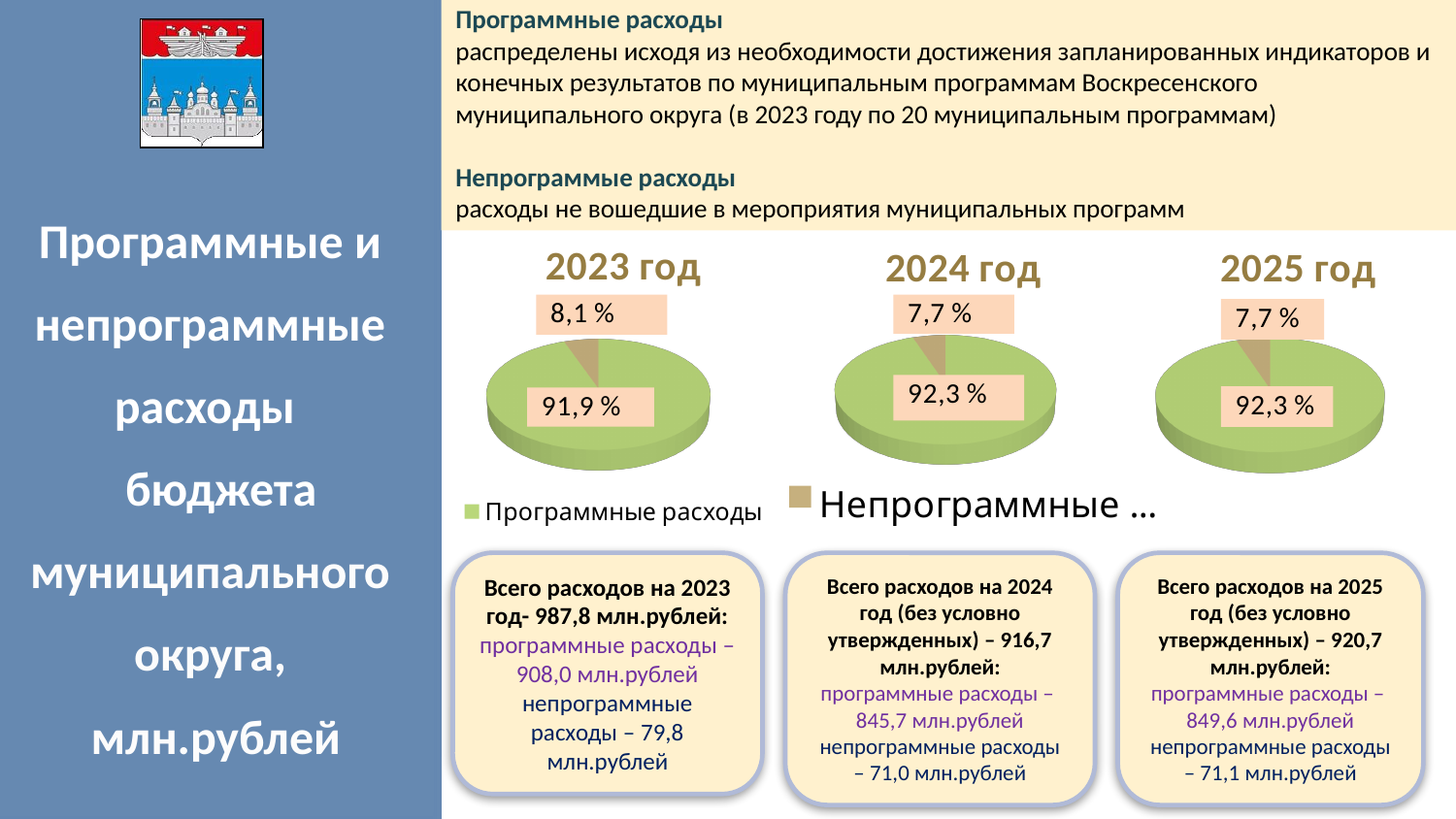
What kind of chart is used for 2023 год, 2024 год and 2025 год? Pie chart In the 2023 год pie chart, what share is labelled for the smaller (brown) slice, Непрограммные расходы? 8,1 % In the 2025 год pie chart, which slice is the smallest? Непрограммные расходы In the 2023 год pie chart, which slice is the largest? Программные расходы What is the difference between the Программные расходы share and the Непрограммные расходы share in the 2023 год pie chart? 83,8 % In the 2023 год pie chart, what share is labelled for the larger (green) slice, Программные расходы? 91,9 % In the 2025 год pie chart, what share is labelled for Непрограммные расходы? 7,7 % In the 2024 год pie chart, what share is labelled for Программные расходы? 92,3 % Is the Непрограммные расходы share in the 2023 год pie chart larger or smaller than in the 2024 год pie chart? Larger How many slices does the 2023 год pie chart have? 2 Which colour represents Программные расходы in the pie charts? Green In the 2024 год pie chart, what share is labelled for Непрограммные расходы? 7,7 %